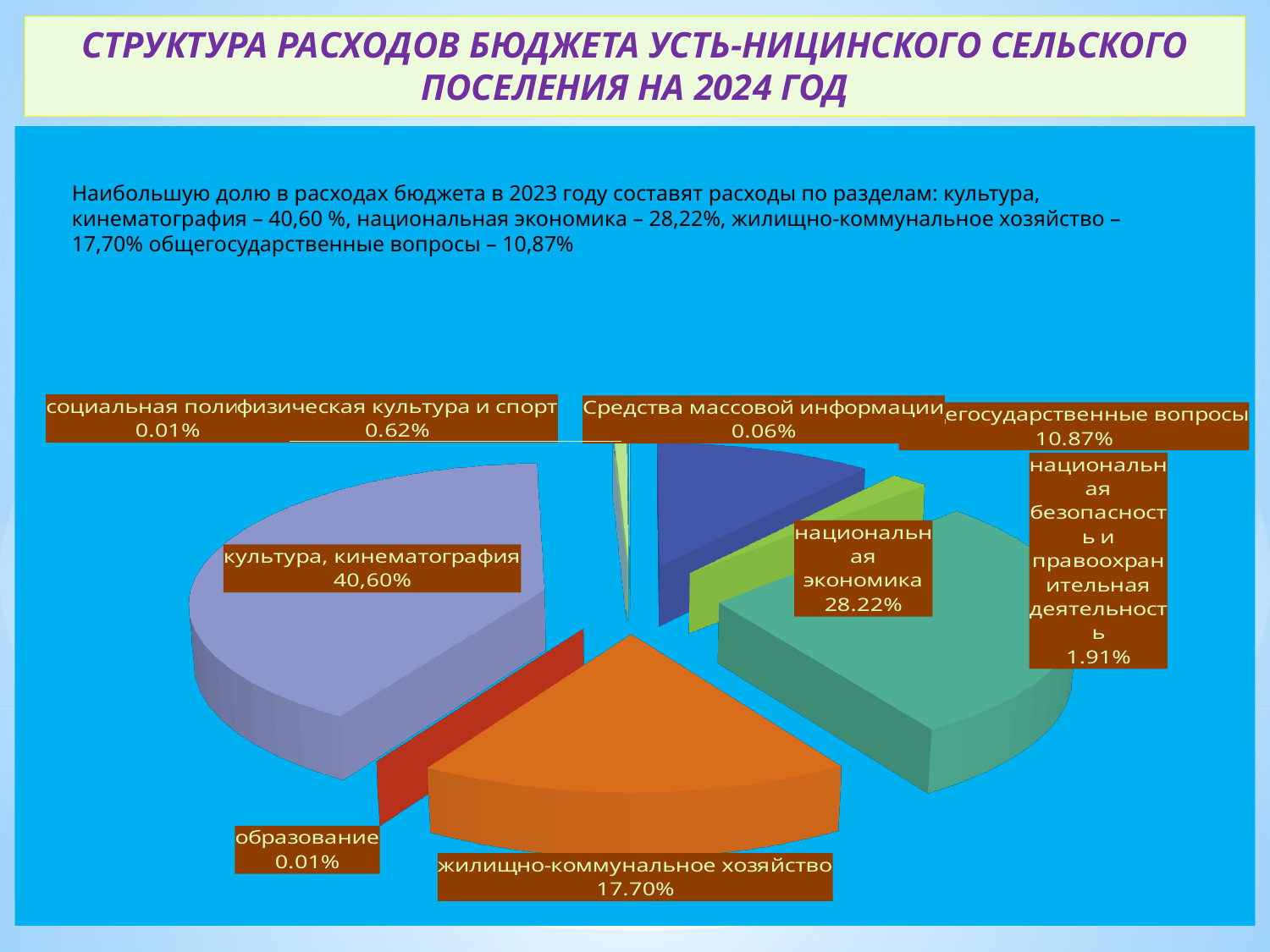
What is the value shown for 'национальная экономика'? 28.22% How many categories (slices) are labelled on the pie chart? 9 What is the difference between the shares of 'национальная экономика' and 'жилищно-коммунальное хозяйство'? 10.52% What kind of chart is shown on the slide? pie chart What is the value shown for 'национальная безопасность и правоохранительная деятельность'? 1.91% Which category has the largest slice of the pie? культура, кинематография What share of the budget expenditure does the slice 'культура, кинематография' have? 40,60% What is the value shown for 'физическая культура и спорт'? 0.62% Which is larger, 'национальная экономика' or 'жилищно-коммунальное хозяйство'? национальная экономика What is the value shown for 'образование'? 0.01% What is the value shown for 'жилищно-коммунальное хозяйство'? 17.70% What is the value shown for 'Средства массовой информации'? 0.06%